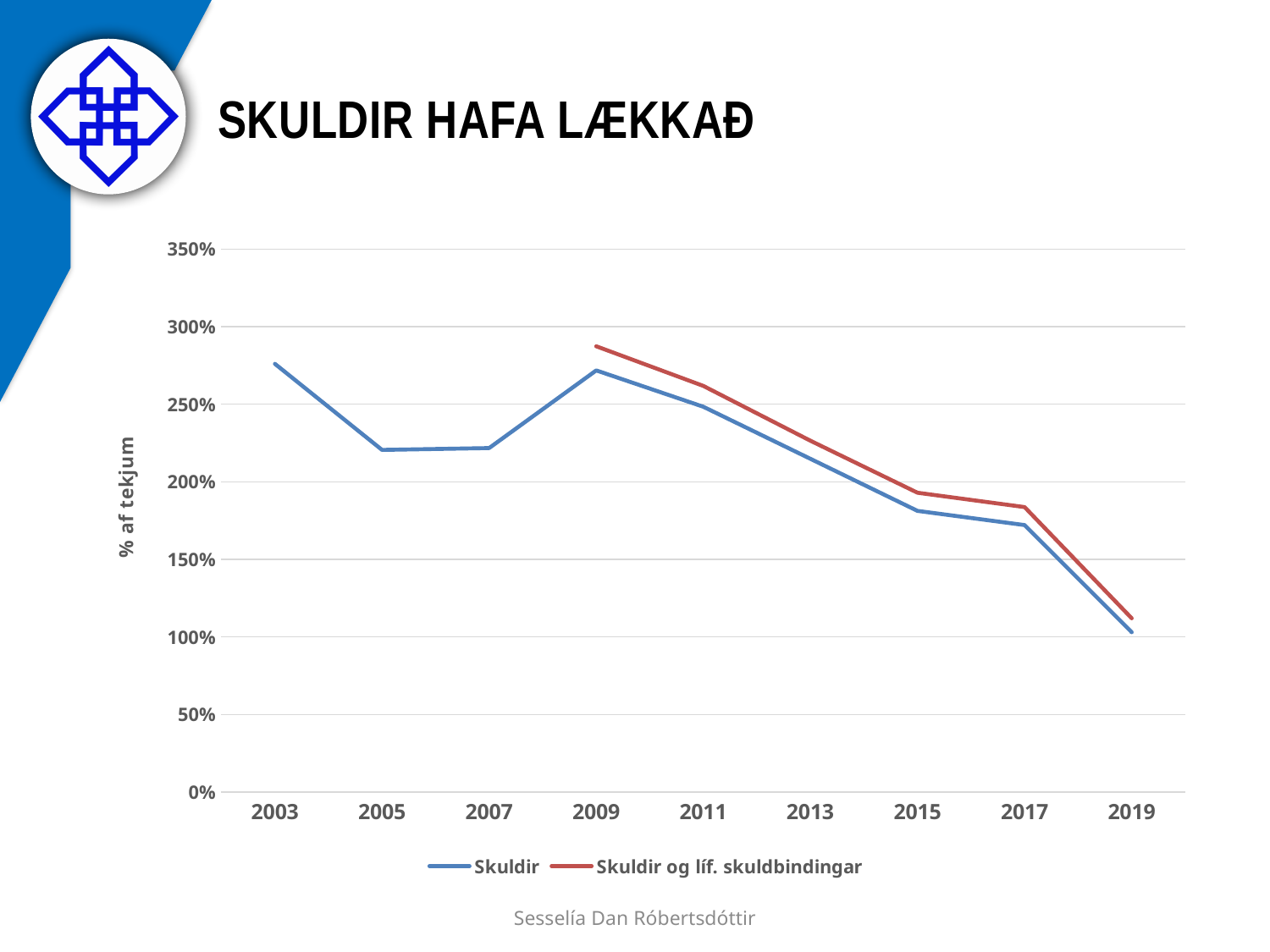
Which year has the highest value for the Skuldir og líf. skuldbindingar series? 2009 How many series does the legend list? 2 How many years are shown on the x axis? 9 Which year has the lowest value for the Skuldir series? 2019 Is the Skuldir og líf. skuldbindingar value for 2009 greater or less than 250%? greater What kind of chart is shown on the slide? Line chart Do the values of the Skuldir series rise or fall from 2009 to 2019? Fall Is the Skuldir value for 2003 greater or less than 250%? greater Is the Skuldir value for 2005 greater or less than 250%? less What is the title of the vertical axis? % af tekjum Which is larger in 2013: the Skuldir value or the Skuldir og líf. skuldbindingar value? Skuldir og líf. skuldbindingar